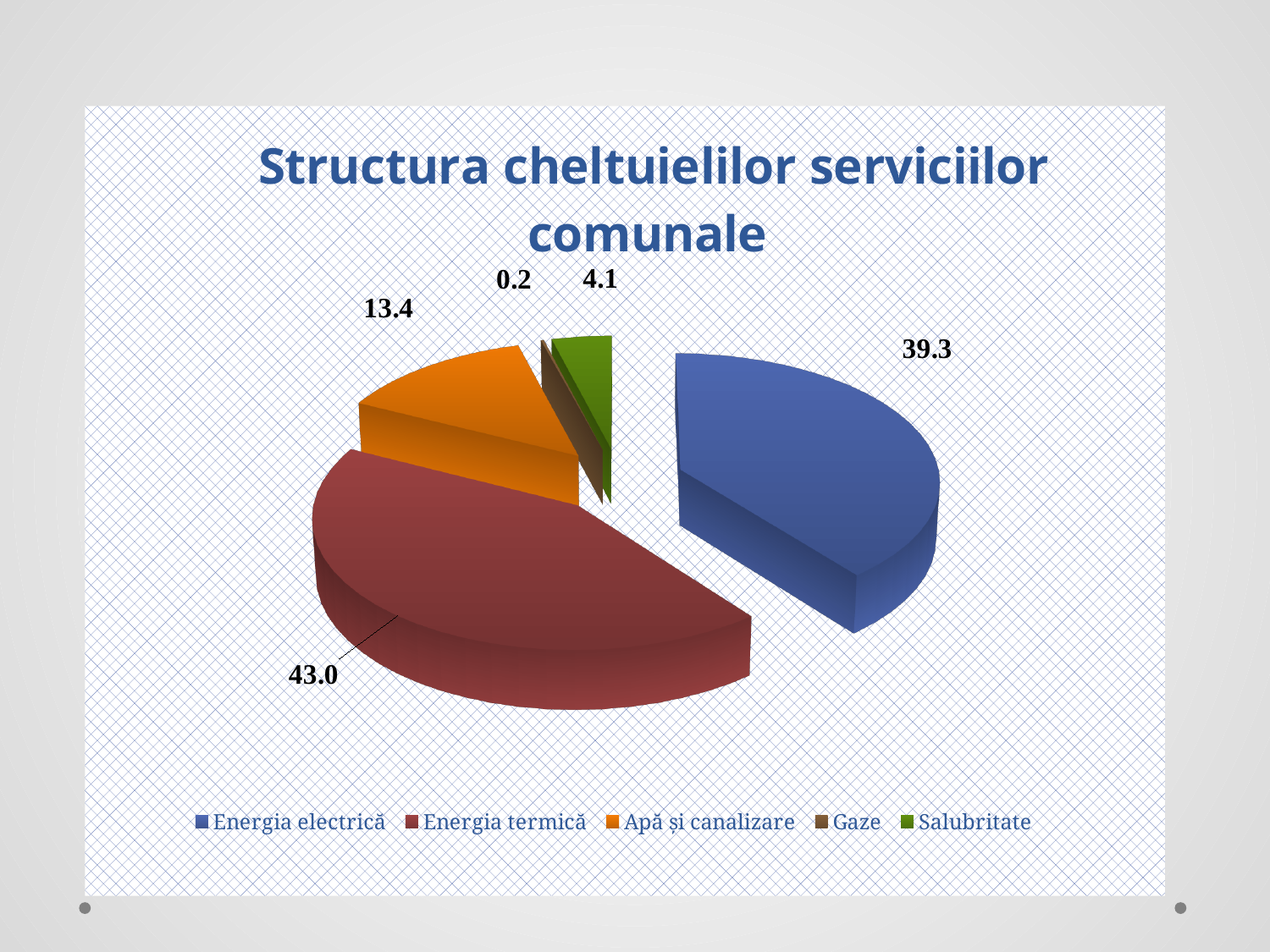
Which category has the smallest slice? Gaze What is the difference between the values for Energia termică and Energia electrică? 3.7 What is the value for Gaze? 0.2 What kind of chart is shown on the slide? Pie chart Which category has the largest slice? Energia termică Which is larger, the value for Apă și canalizare or the value for Salubritate? Apă și canalizare What is the value for Apă și canalizare? 13.4 What is the value for Energia electrică? 39.3 What is the value for Salubritate? 4.1 What is the title of the chart? Structura cheltuielilor serviciilor comunale How many categories does the legend list? 5 What is the value for Energia termică? 43.0